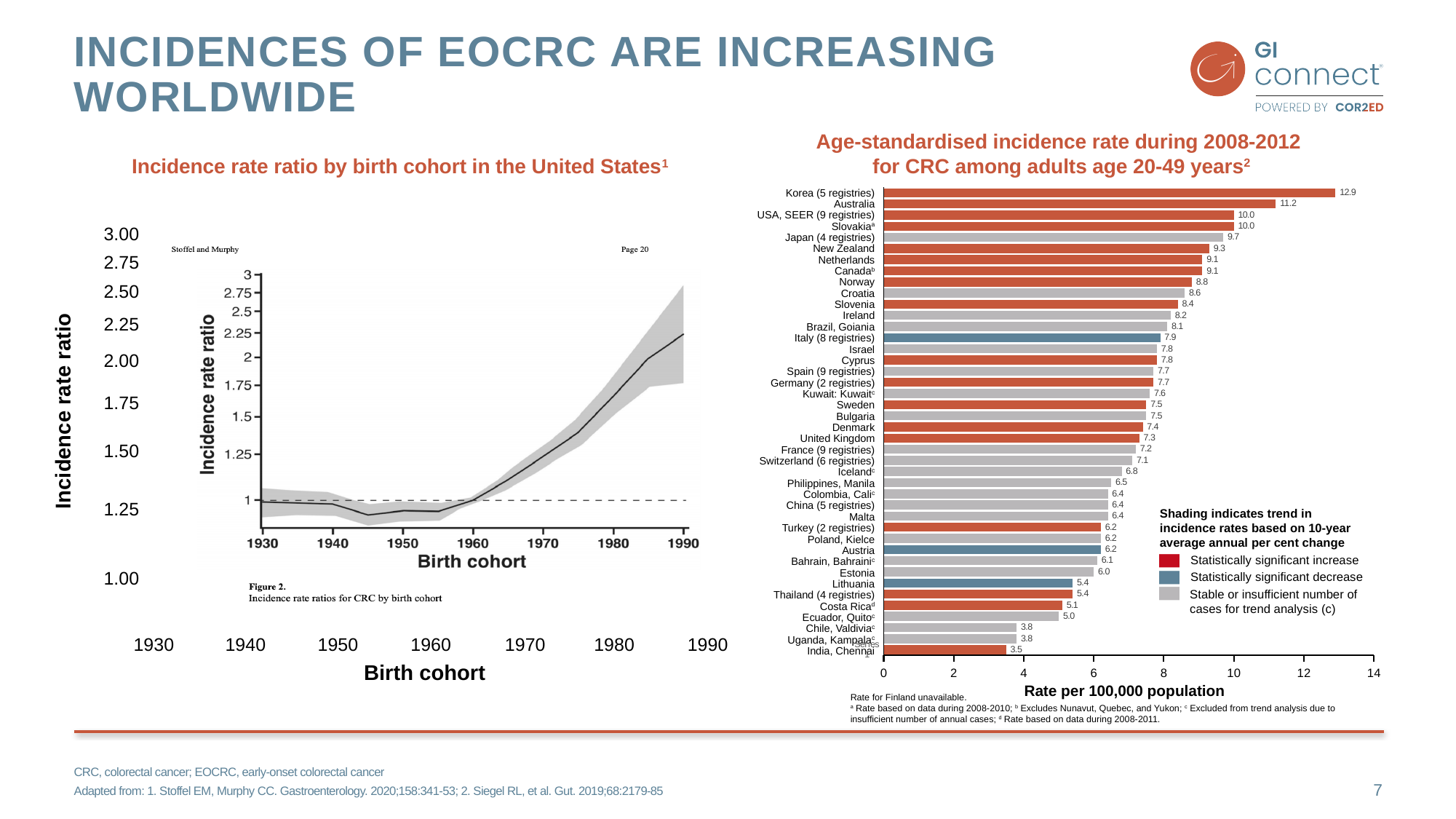
On the right chart (Age-standardised incidence rate during 2008-2012), what is the rate for Korea (5 registries)? 12.9 On the right chart (Age-standardised incidence rate during 2008-2012), which country has the highest rate? Korea (5 registries) On the right chart (Age-standardised incidence rate during 2008-2012), what is the x-axis label? Rate per 100,000 population On the right chart (Age-standardised incidence rate during 2008-2012), which has a higher rate, Japan (4 registries) or Norway? Japan (4 registries) On the right chart (Age-standardised incidence rate during 2008-2012), what is the rate for United Kingdom? 7.3 On the right chart (Age-standardised incidence rate during 2008-2012), which country has the lowest rate? India, Chennai On the right chart (Age-standardised incidence rate during 2008-2012), what is the rate for Italy (8 registries)? 7.9 What kind of chart is the left chart, Incidence rate ratio by birth cohort in the United States? Line chart On the right chart (Age-standardised incidence rate during 2008-2012), what is the difference between the rates for Korea (5 registries) and Australia? 1.7 On the left chart (Incidence rate ratio by birth cohort in the United States), is the incidence rate ratio for the 1990 birth cohort greater or less than 2.00? greater On the right chart (Age-standardised incidence rate during 2008-2012), how many legend entries describe the bar shading? 3 On the left chart (Incidence rate ratio by birth cohort in the United States), does the incidence rate ratio rise or fall between the 1960 and 1990 birth cohorts? rise